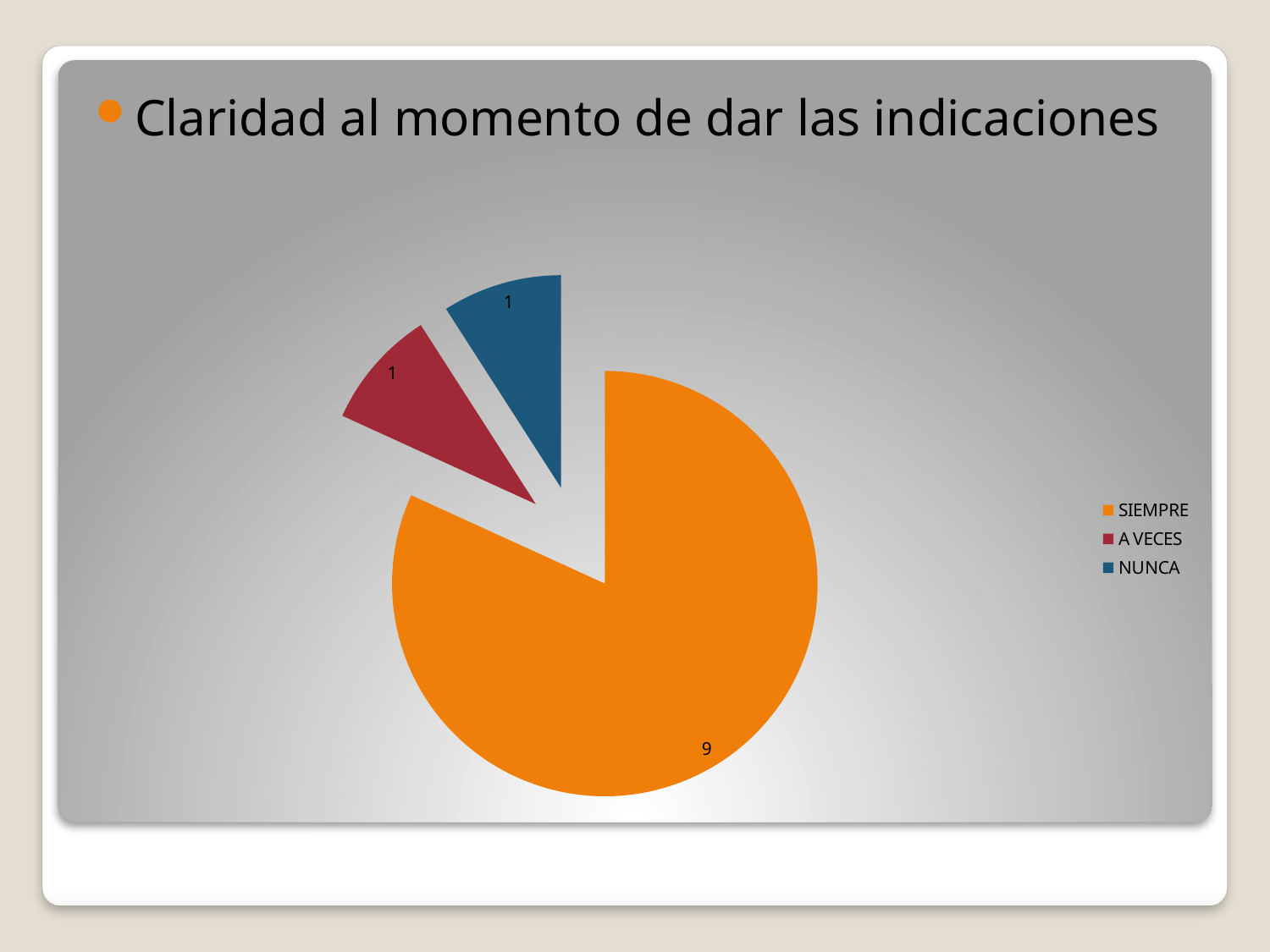
What is the value for NUNCA? 1 What is the total of all slices in the pie? 11 How many categories does the legend list? 3 What is the value for SIEMPRE? 9 What is the value for A VECES? 1 What kind of chart is shown on the slide? pie chart Which category has the largest slice? SIEMPRE What colour is the SIEMPRE slice? orange What is the difference between the values for SIEMPRE and A VECES? 8 What is the title text on the slide above the chart? Claridad al momento de dar las indicaciones Which is larger, the value for SIEMPRE or the value for NUNCA? SIEMPRE